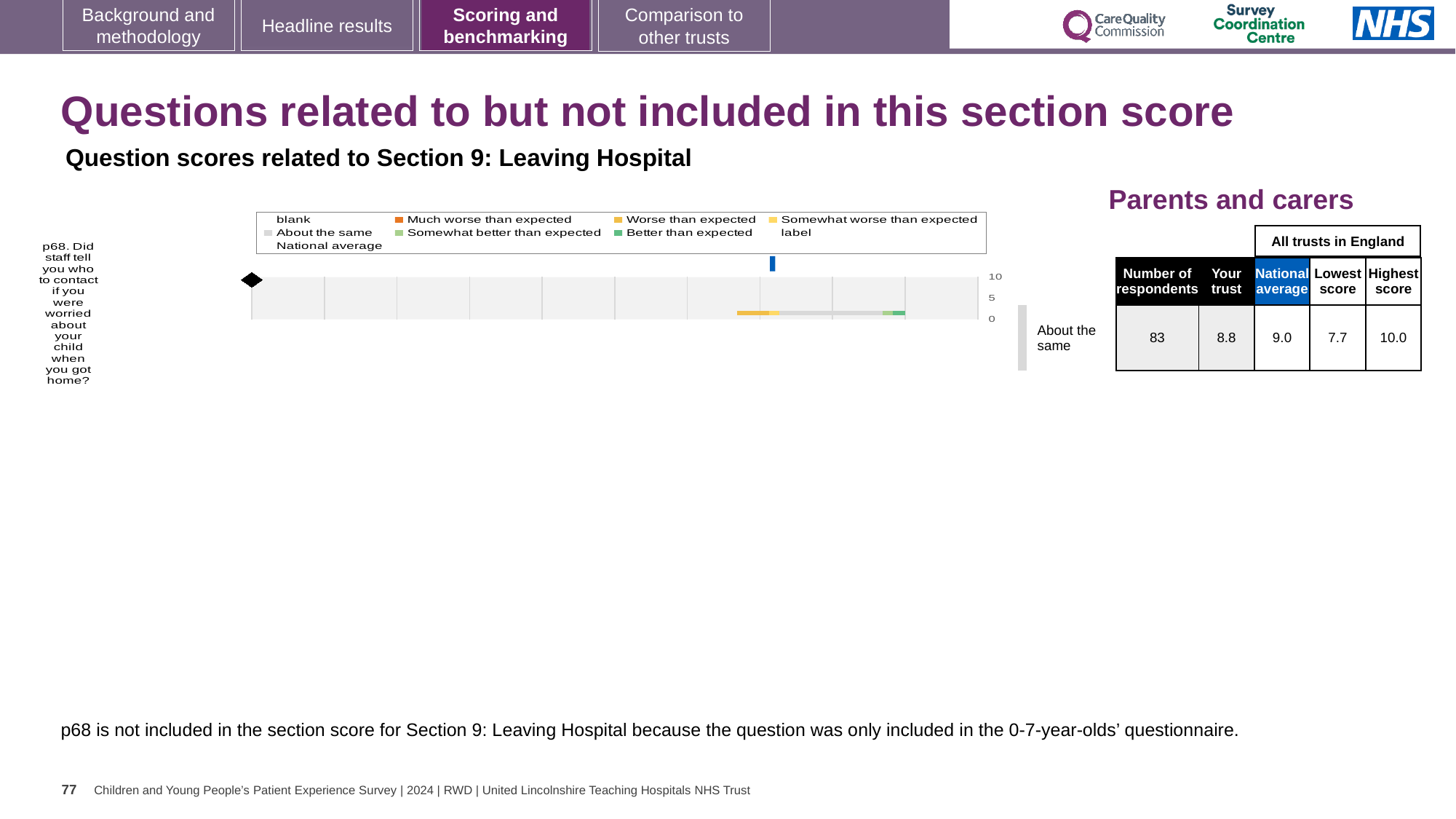
What is the difference between the highest score and the lowest score for question p68? 2.3 Which is larger for question p68, the 'Your trust' score or the national average? National average How many questions are plotted in the chart? 1 How many respondents answered question p68? 83 How many legend entries in the chart contain the word 'expected'? 5 What rating label is shown to the right of the chart for question p68? About the same What is the highest value shown on the chart's numeric axis? 10 What kind of chart is used to show the p68 question score? bar chart What is the highest score among all trusts in England for question p68? 10.0 What is the lowest score among all trusts in England for question p68? 7.7 What is the national average score for question p68? 9.0 What is the 'Your trust' score for question p68? 8.8